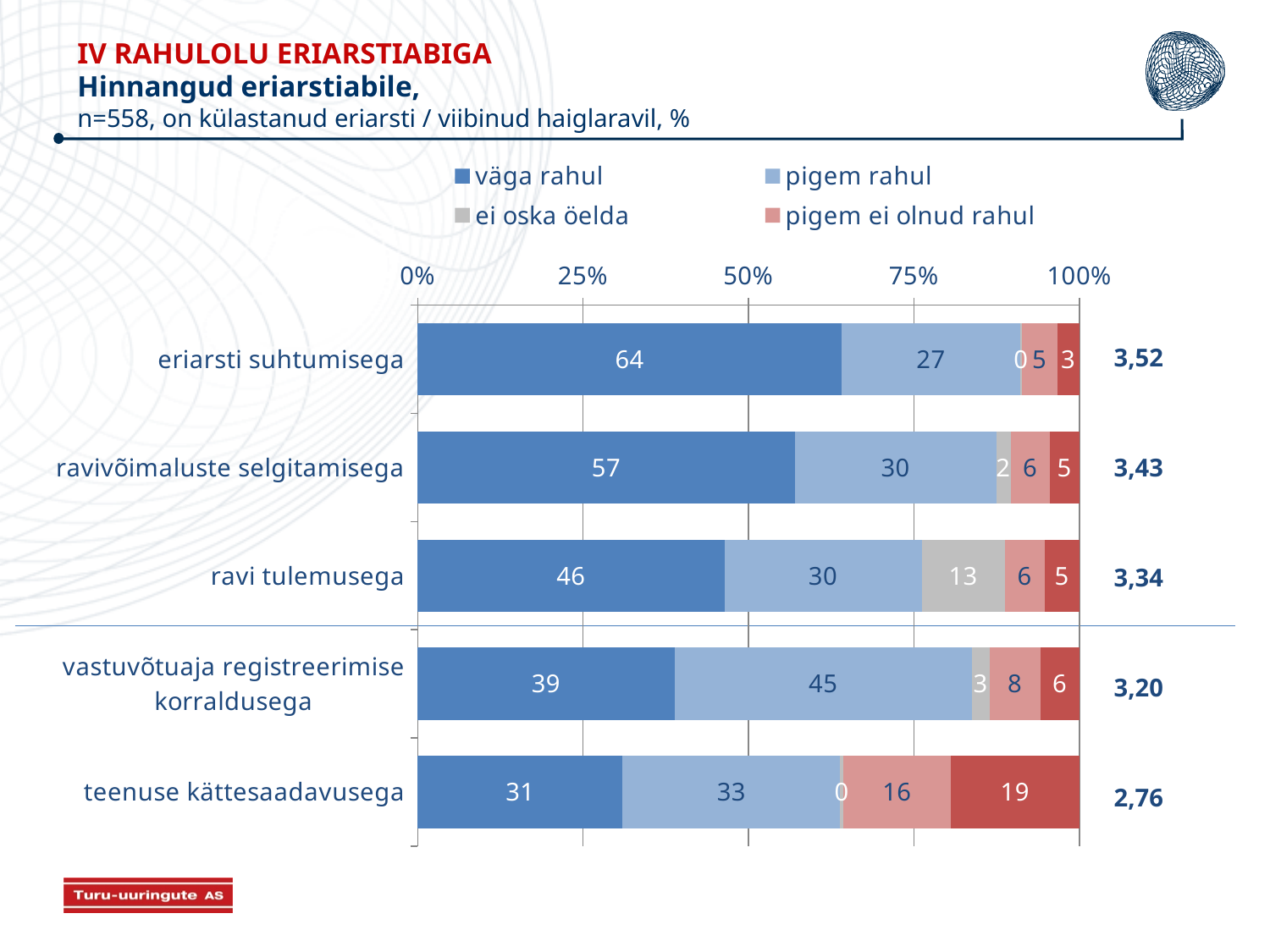
How many series does the legend list? 4 Is the 'väga rahul' value for 'ravivõimaluste selgitamisega' greater or less than 50%? greater What is the difference between the 'väga rahul' values for 'eriarsti suhtumisega' and 'teenuse kättesaadavusega'? 33 How many categories are shown on the chart? 5 What is the 'väga rahul' value for 'ravi tulemusega'? 46 What is the mean score shown to the right of the bar for 'teenuse kättesaadavusega'? 2,76 Which category has the lowest 'väga rahul' value? teenuse kättesaadavusega Which has the larger 'pigem rahul' value: 'vastuvõtuaja registreerimise korraldusega' or 'ravi tulemusega'? vastuvõtuaja registreerimise korraldusega What is the 'pigem ei olnud rahul' value for 'teenuse kättesaadavusega'? 16 Which category has the highest 'väga rahul' value? eriarsti suhtumisega What is the 'ei oska öelda' value for 'ravi tulemusega'? 13 What kind of chart is shown on the slide? stacked bar chart